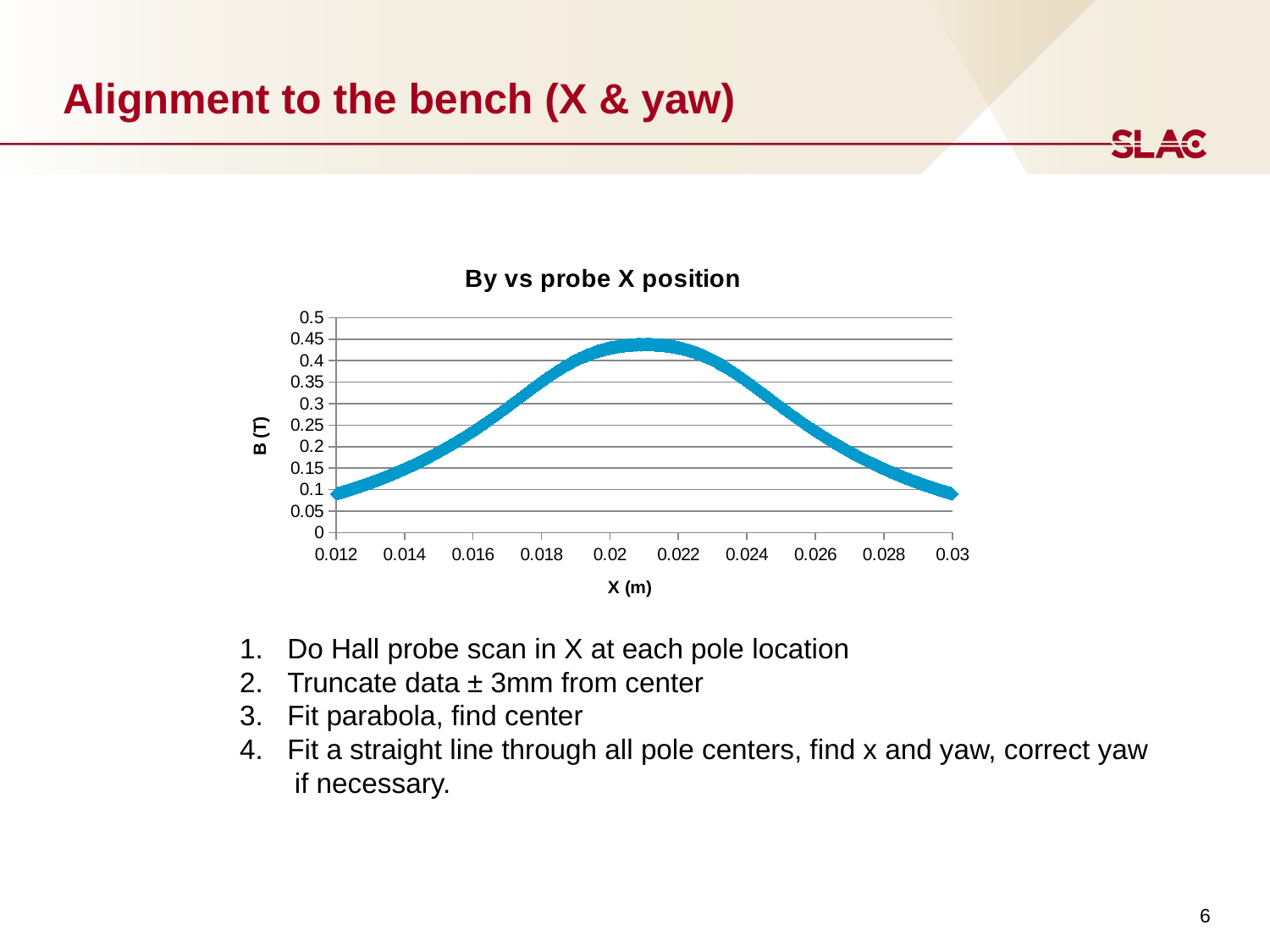
Is the value of B at X = 0.012 m greater or less than 0.15? less What is the label of the vertical axis of the chart? B (T) Which has the larger B value: X = 0.018 m or X = 0.026 m? X = 0.018 m Which has the larger B value: X = 0.02 m or X = 0.012 m? X = 0.02 m How does B change as X increases from 0.012 m to 0.03 m? It rises to a peak and then falls Is the value of B at X = 0.03 m greater or less than 0.15? less Is the peak value of B on the chart greater or less than 0.5? less What kind of chart is shown on the slide? Scatter (line) chart What is the title of the chart? By vs probe X position